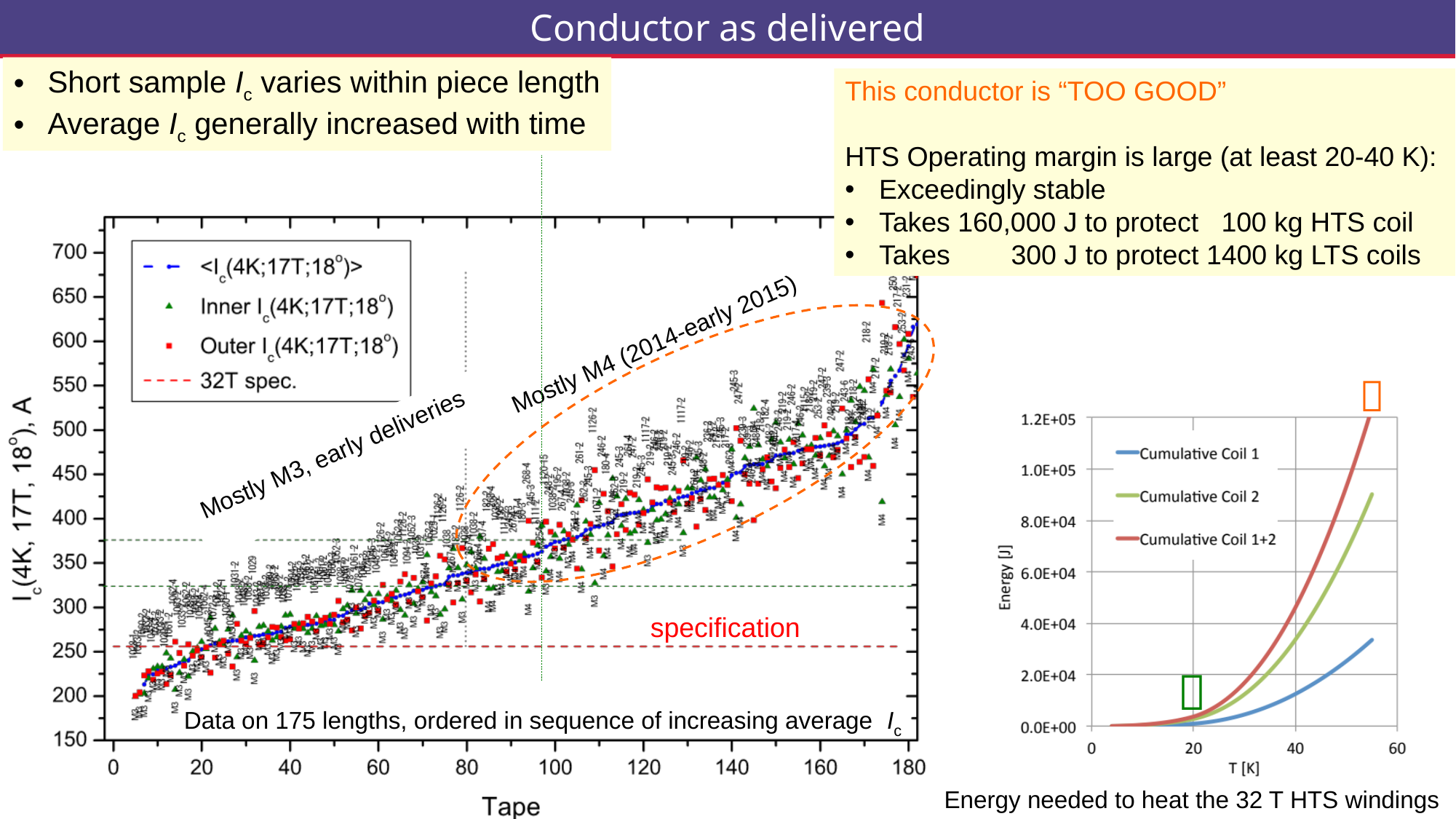
On the right chart (Energy versus T), which series has the lowest energy at the right end of the curves? Cumulative Coil 1 On the left chart (Ic versus Tape), how many lengths does the chart say the data covers? 175 On the left chart (Ic versus Tape), is the 32T specification line greater or less than 300 A? less On the left chart (Ic versus Tape), is the 32T specification line greater or less than 200 A? greater On the right chart (Energy versus T), how many series does the legend list? 3 On the left chart (Ic versus Tape), how many series does the legend list? 4 On the left chart (Ic versus Tape), what is the label of the x axis? Tape On the right chart (Energy versus T), which series reaches the highest energy at the right end of the curves? Cumulative Coil 1+2 On the left chart (Ic versus Tape), which legend entry is drawn as red squares? Outer Ic(4K;17T;18°) On the right chart (Energy versus T), is the value of Cumulative Coil 1 at its right end greater or less than 4.0E+04 J? less What kind of chart is the right chart (Energy versus T)? line chart On the left chart (Ic versus Tape), does the average Ic (blue dashed line) rise or fall as the tape number increases? rise